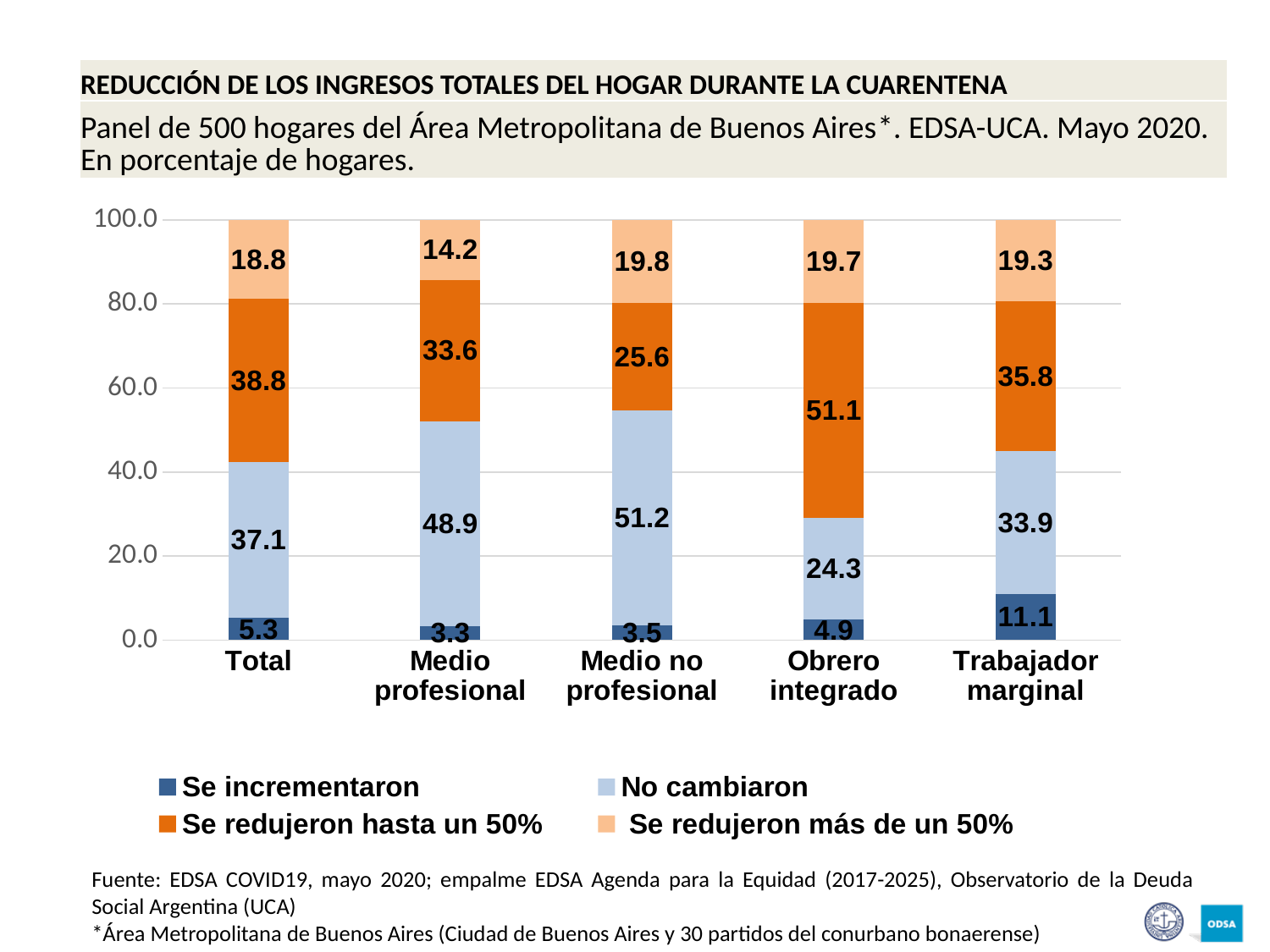
Which category has the highest value for "Se incrementaron"? Trabajador marginal Which category has the lowest value for "Se redujeron más de un 50%"? Medio profesional What is the value for "No cambiaron" in the "Medio no profesional" category? 51.2 How many categories are shown on the x axis of the chart? 5 In the "Obrero integrado" category, which is larger: "No cambiaron" or "Se redujeron hasta un 50%"? Se redujeron hasta un 50% What is the difference between the "Se redujeron hasta un 50%" value for "Obrero integrado" and for "Total"? 12.3 What kind of chart is shown on the slide? Stacked bar chart What is the value for "Se incrementaron" in the "Trabajador marginal" category? 11.1 How many series does the legend list? 4 What is the value for "Se redujeron más de un 50%" in the "Obrero integrado" category? 19.7 What percentage of households in the "Total" category reported that their income "Se redujeron hasta un 50%"? 38.8 Which category has the highest value for "Se redujeron hasta un 50%"? Obrero integrado